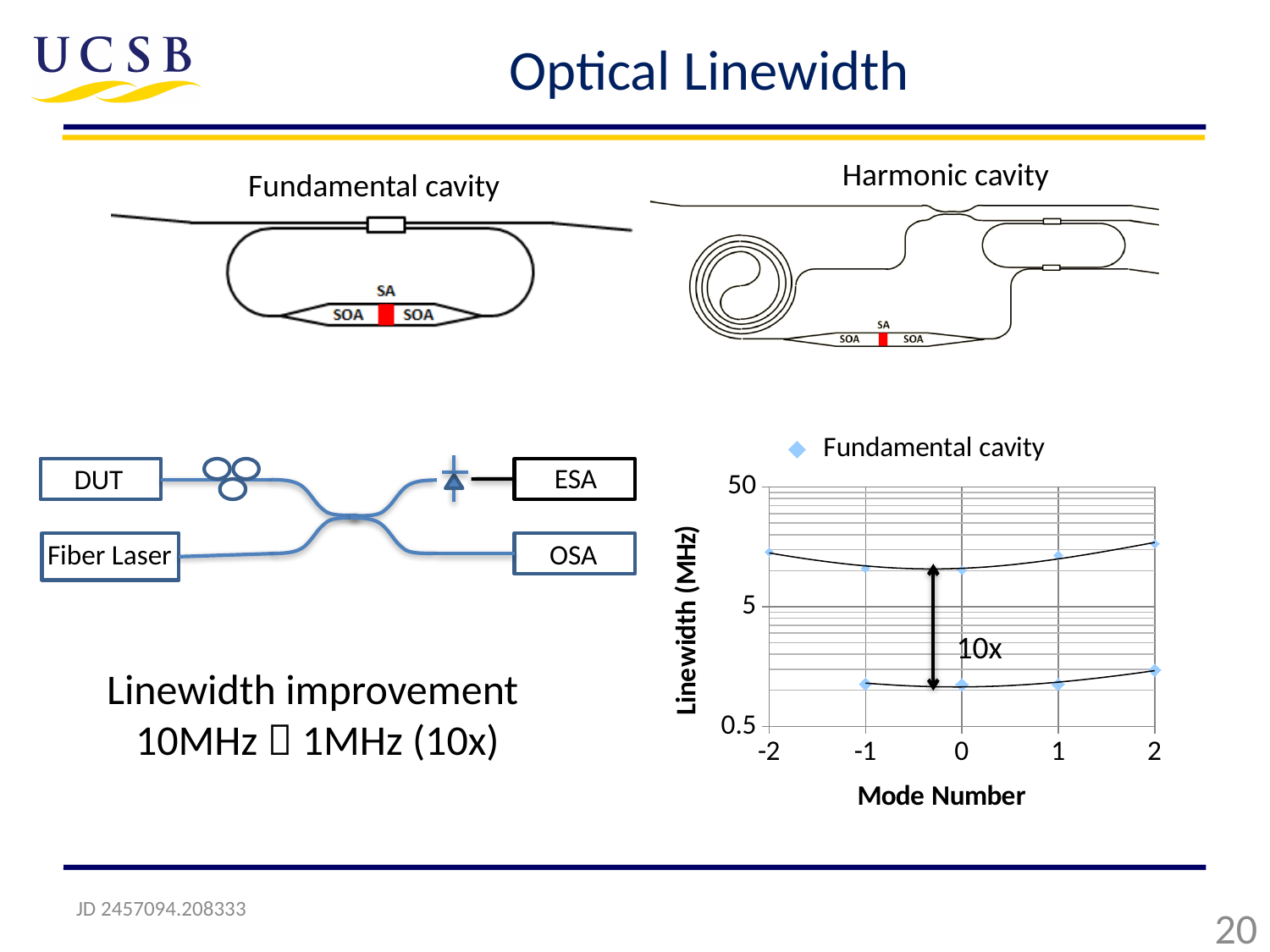
Is the linewidth of the lower series at mode number 0 greater or less than 5? less Is the linewidth of the upper series at mode number 0 greater or less than 5? greater Is the linewidth of the lower series at mode number 2 greater or less than 0.5? greater What is the title of the y axis of the chart? Linewidth (MHz) How many mode numbers are labelled on the x axis of the chart? 5 How many entries does the chart's legend list? 1 What is the title of the x axis of the chart? Mode Number At mode number 0, which series has the larger linewidth, the upper series or the lower series? the upper series What kind of chart is shown on the slide? scatter chart Between mode number 0 and mode number 2, does the linewidth of the upper series rise or fall? rise